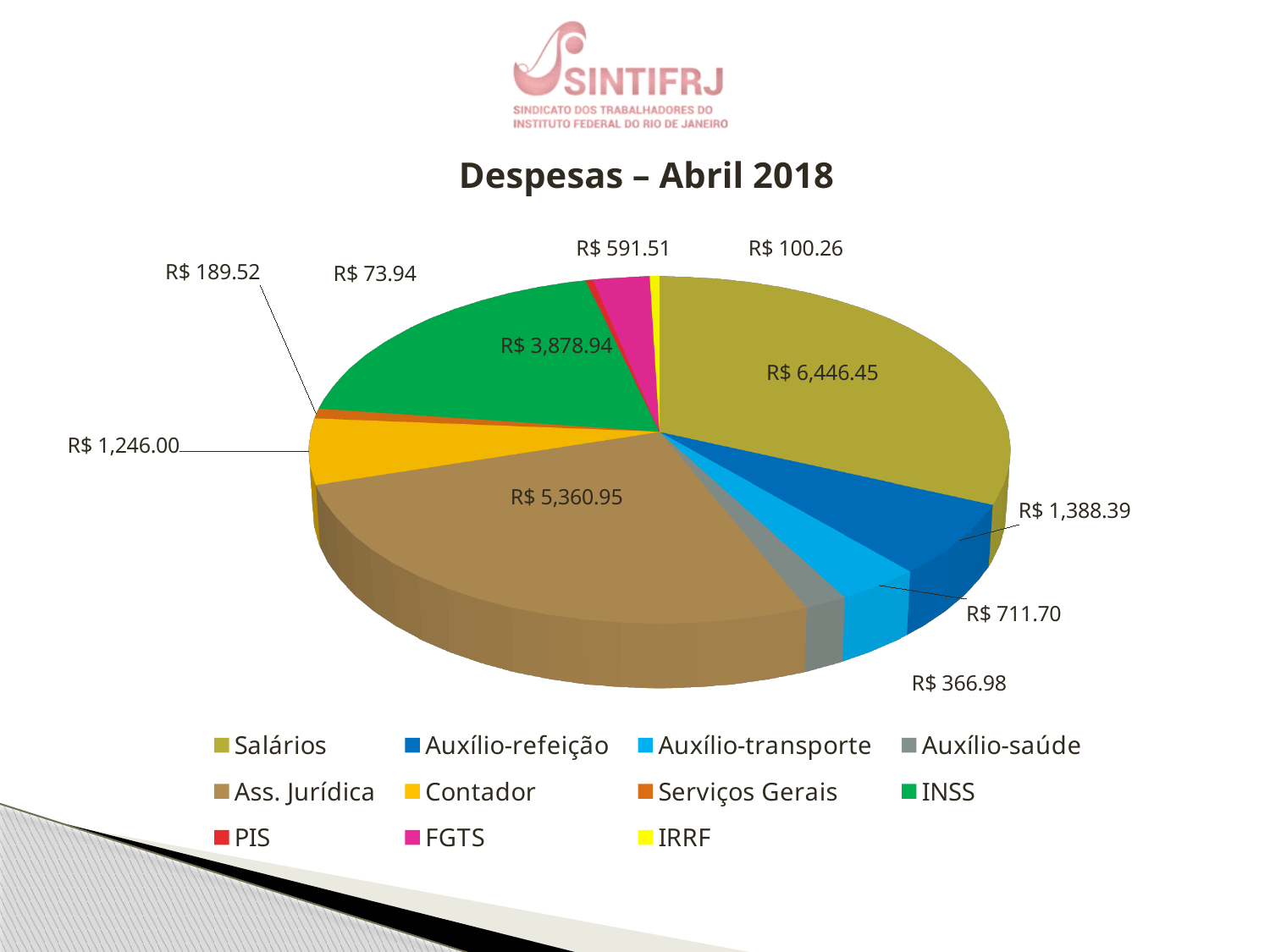
Which is larger, Auxílio-refeição or Auxílio-transporte? Auxílio-refeição What is the value of the INSS slice? R$ 3,878.94 What is the value of the Salários slice? R$ 6,446.45 What type of chart is shown on the slide? Pie chart What is the title of the chart? Despesas – Abril 2018 Which category has the smallest expense? PIS What is the difference between the Salários and Ass. Jurídica values? R$ 1,085.50 How many categories does the pie chart have? 11 Which category has the largest expense? Salários What is the value of the Contador slice? R$ 1,246.00 What is the value of the FGTS slice? R$ 591.51 What is the value of the Ass. Jurídica slice? R$ 5,360.95